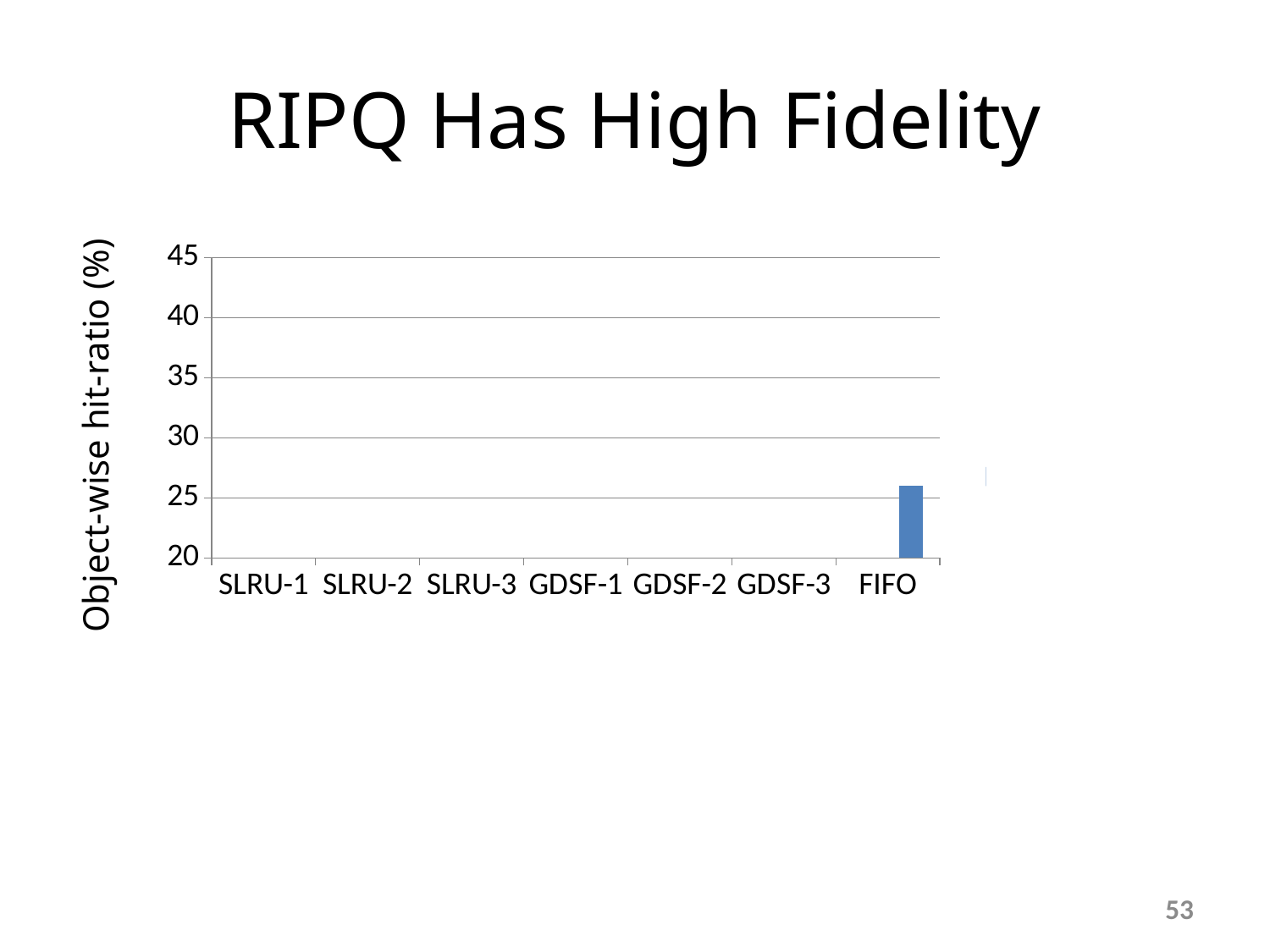
What is the label of the y axis of the chart? Object-wise hit-ratio (%) Which category is the only one with a visible bar in the chart? FIFO What kind of chart is shown on the slide? bar chart How many categories are listed along the x axis of the chart? 7 What is the highest value shown on the y axis of the chart? 45 What is the title of the slide containing the chart? RIPQ Has High Fidelity What is the lowest value shown on the y axis of the chart? 20 Is the value for FIFO greater or less than 25? greater Is the value for FIFO greater or less than 40? less Is the value for FIFO greater or less than 30? less